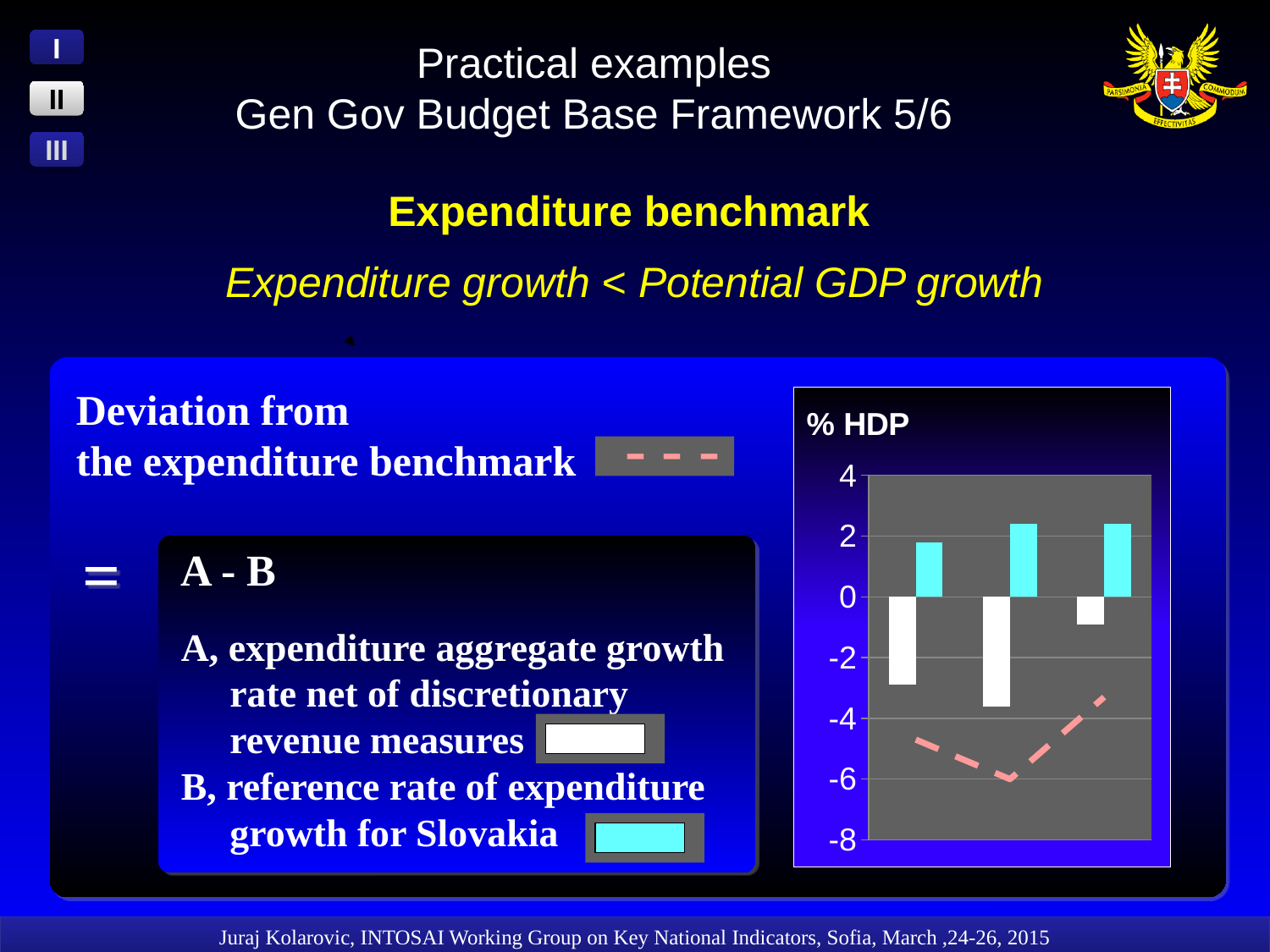
How many groups of bars are plotted in the chart? 3 How many white bars are plotted in the chart? 3 What is the highest value shown on the chart's vertical axis? 4 Is the value of the leftmost cyan bar greater or less than 0? greater What is the title shown at the top of the chart? % HDP Is the value of the leftmost white bar greater or less than -2? less Is the value of the rightmost white bar greater or less than -2? greater Which white bar has the lowest value: the leftmost, middle or rightmost? middle Which white bar has the highest value: the leftmost, middle or rightmost? rightmost What kind of chart is shown on the slide? bar and line chart Does the dashed line fall or rise between the first and second groups of bars? fall